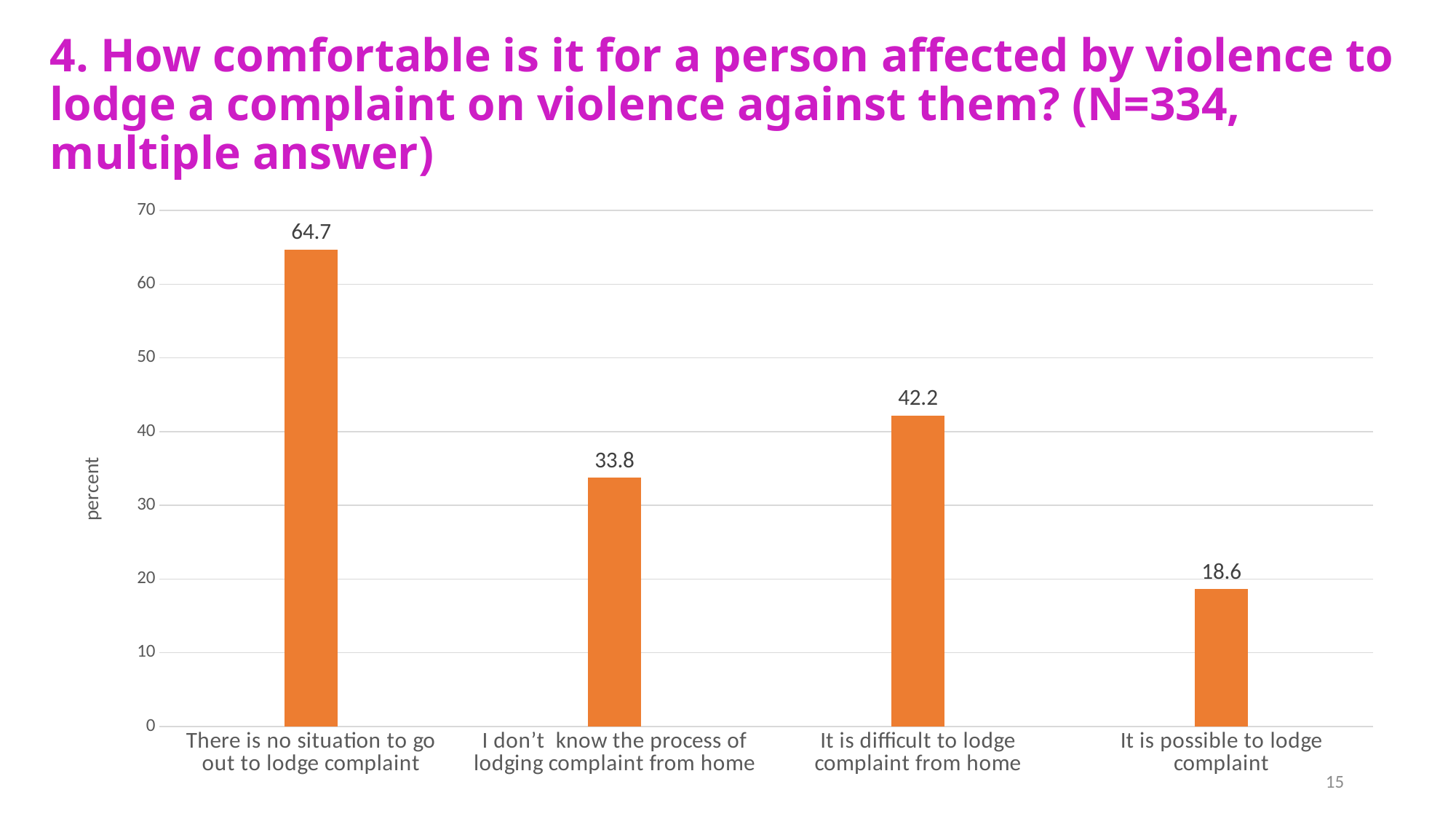
What is the difference between the values for "There is no situation to go out to lodge complaint" and "It is possible to lodge complaint"? 46.1 How many categories are shown in the chart? 4 Which category has the lowest value? It is possible to lodge complaint What is the value for "It is difficult to lodge complaint from home"? 42.2 What is the label on the vertical axis of the chart? percent Which category has the highest value? There is no situation to go out to lodge complaint Which is larger: the value for "It is difficult to lodge complaint from home" or "I don't know the process of lodging complaint from home"? It is difficult to lodge complaint from home What is the value for "It is possible to lodge complaint"? 18.6 What is the value for "I don't know the process of lodging complaint from home"? 33.8 Is the value for "It is possible to lodge complaint" greater or less than 20? less What kind of chart is shown on the slide? bar chart What is the value for "There is no situation to go out to lodge complaint"? 64.7